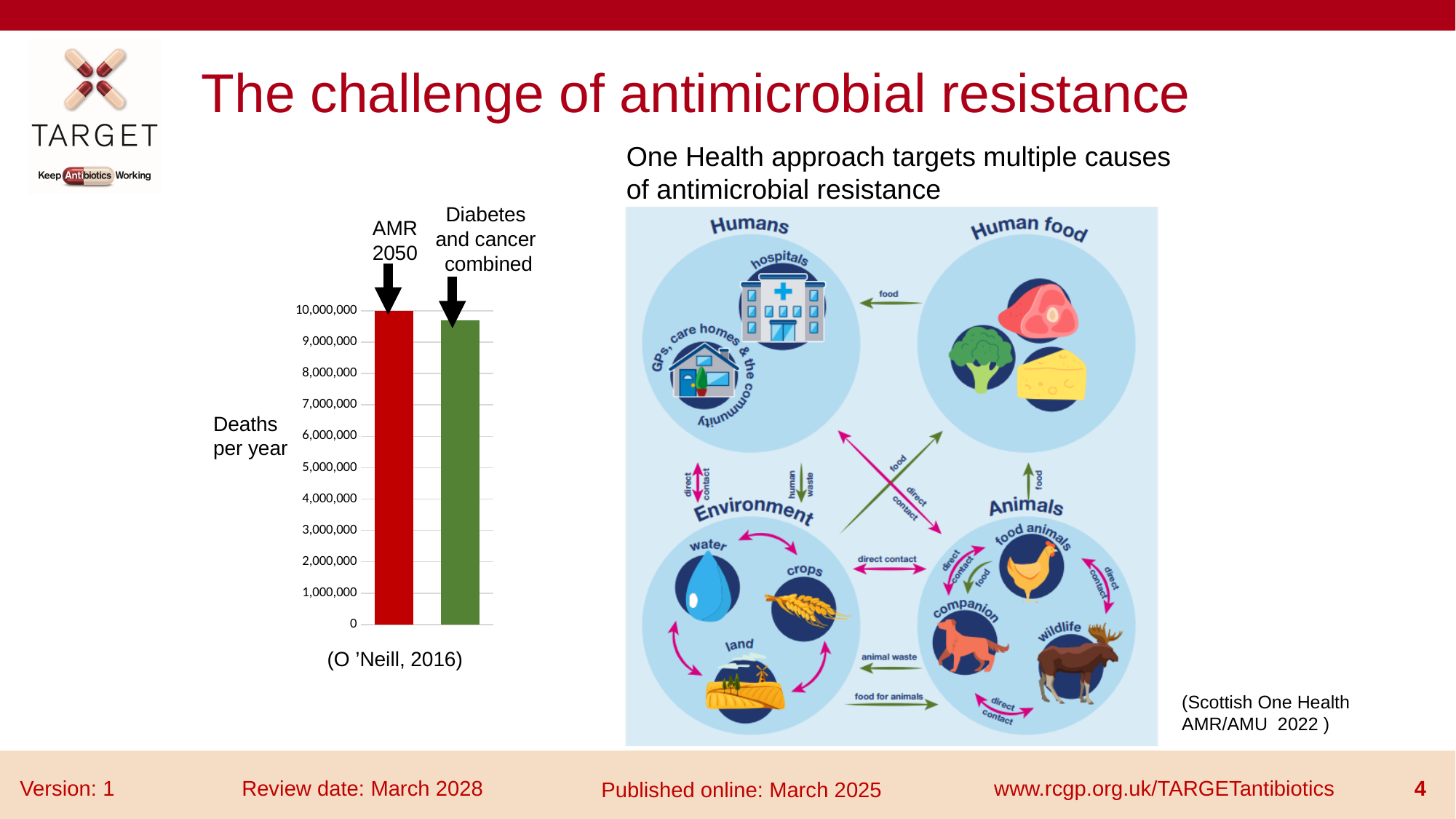
How many bars does the chart show? 2 Which is larger in the chart: deaths per year for AMR 2050 or for Diabetes and cancer combined? AMR 2050 Is the value for Diabetes and cancer combined greater or less than 9,000,000? greater What is the value of deaths per year for AMR 2050 in the chart? 10,000,000 Which category has the highest number of deaths per year in the chart? AMR 2050 What does the y axis of the chart measure? Deaths per year Is the value for Diabetes and cancer combined greater or less than 10,000,000? less What is the highest value shown on the chart's y axis? 10,000,000 What colour is the bar for AMR 2050? red What kind of chart is shown on the slide? bar chart Which category has the lowest number of deaths per year in the chart? Diabetes and cancer combined